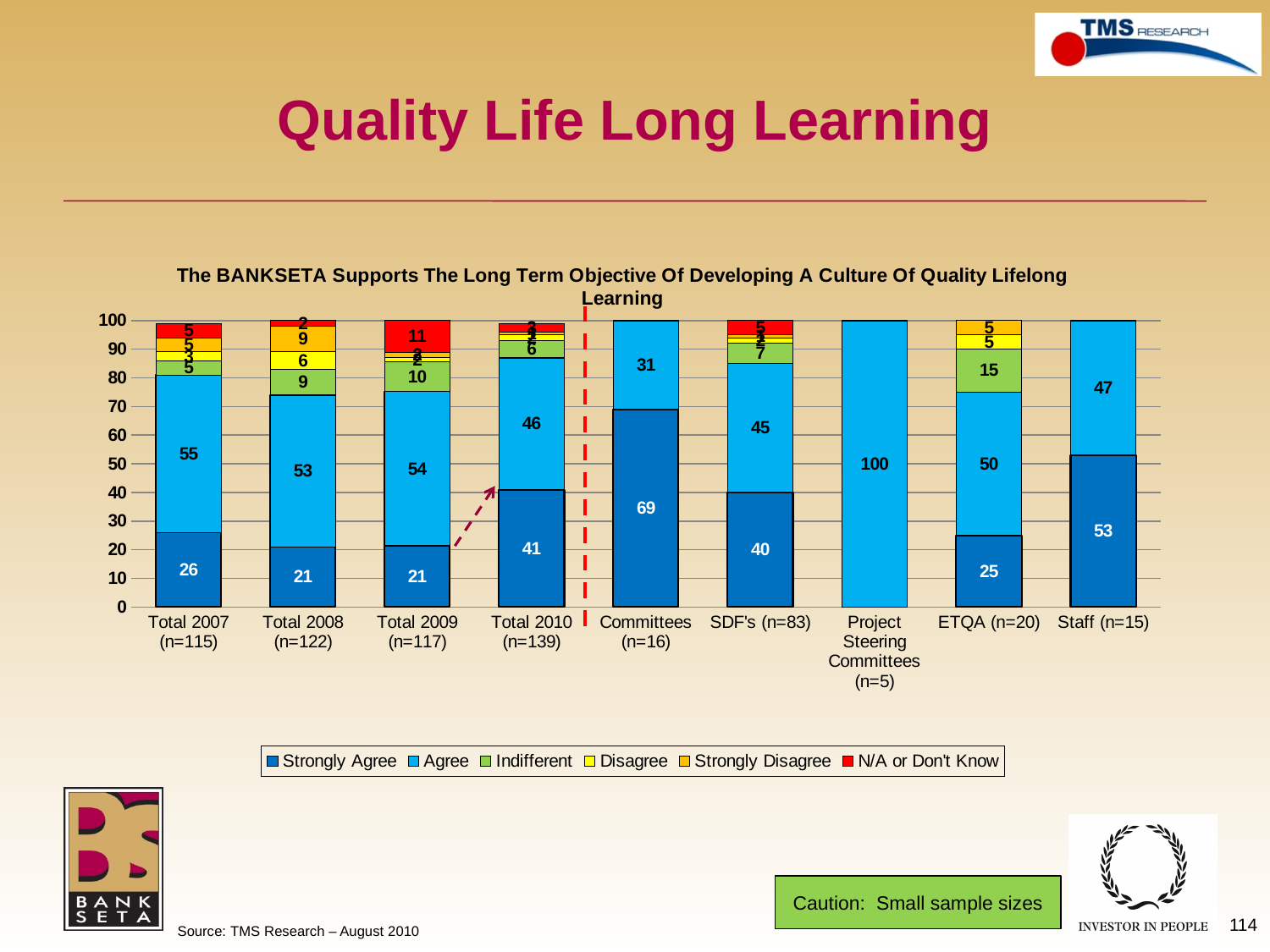
Which category has the lowest Agree value? Committees (n=16) What is the Strongly Agree value for Committees (n=16)? 69 What kind of chart is shown on the slide? Stacked bar chart How many categories are shown along the x axis? 9 Which category has the highest Strongly Agree value? Committees (n=16) What is the N/A or Don't Know value for Total 2009 (n=117)? 11 What is the Indifferent value for ETQA (n=20)? 15 How many series does the legend list? 6 What is the difference between the Strongly Agree values for Total 2010 (n=139) and Total 2009 (n=117)? 20 What is the Strongly Agree value for Total 2010 (n=139)? 41 For Staff (n=15), which is larger: the Strongly Agree value or the Agree value? Strongly Agree What is the Agree value for Project Steering Committees (n=5)? 100